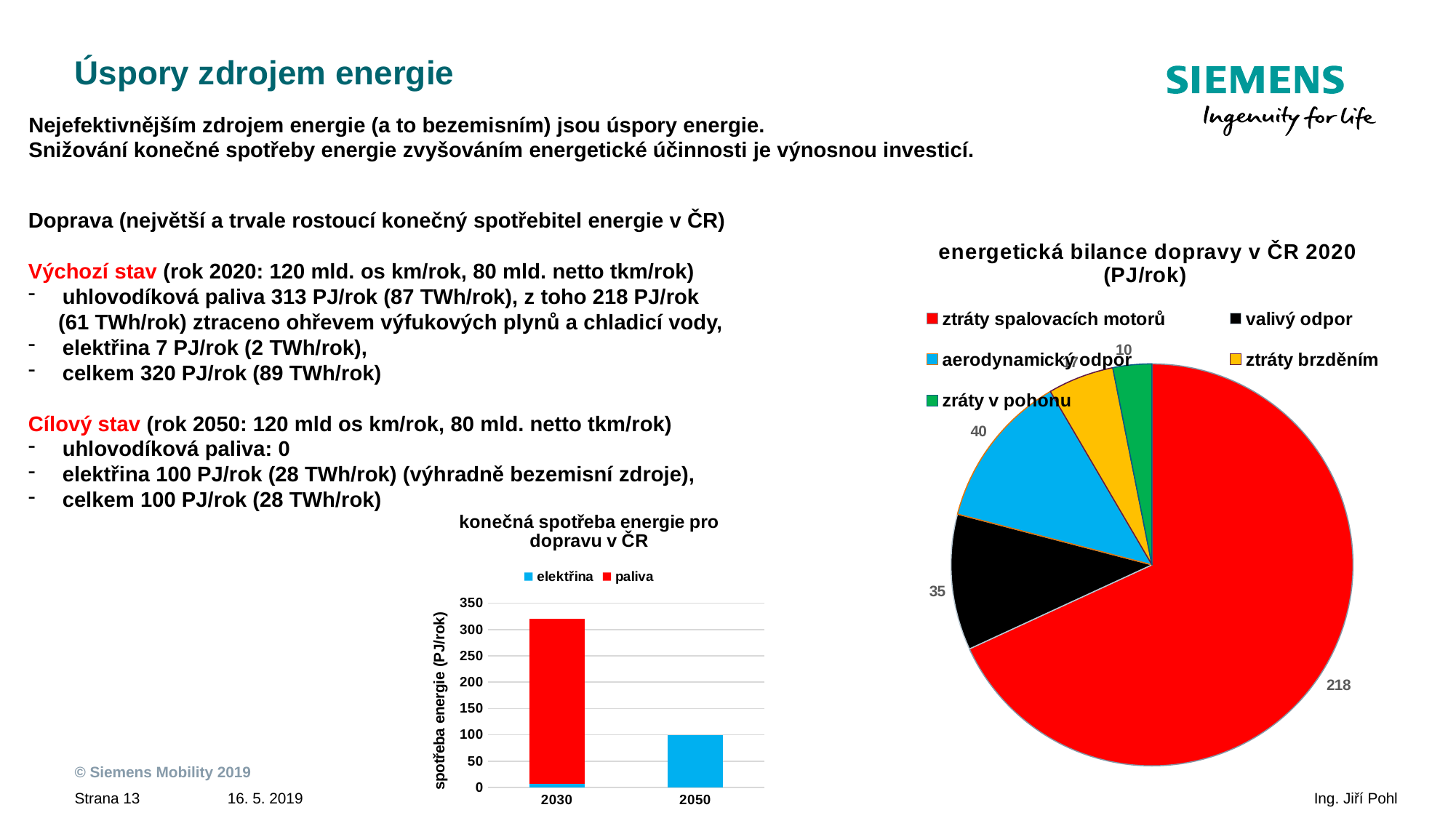
How many categories does the legend of the pie chart 'energetická bilance dopravy v ČR 2020' list? 5 In the pie chart 'energetická bilance dopravy v ČR 2020', which category has the largest slice? ztráty spalovacích motorů In the pie chart 'energetická bilance dopravy v ČR 2020', what is the value for ztráty spalovacích motorů? 218 In the pie chart 'energetická bilance dopravy v ČR 2020', what is the value for aerodynamický odpor? 40 What kind of chart is the chart titled 'konečná spotřeba energie pro dopravu v ČR'? bar chart What kind of chart is the chart titled 'energetická bilance dopravy v ČR 2020 (PJ/rok)'? pie chart In the bar chart 'konečná spotřeba energie pro dopravu v ČR', is the value for paliva in 2030 greater or less than 300? greater In the pie chart 'energetická bilance dopravy v ČR 2020', what is the value for zráty v pohonu? 10 In the pie chart 'energetická bilance dopravy v ČR 2020', what is the value for valivý odpor? 35 How many years are shown on the x axis of the bar chart 'konečná spotřeba energie pro dopravu v ČR'? 2 In the bar chart 'konečná spotřeba energie pro dopravu v ČR', which year has the higher total energy consumption, 2030 or 2050? 2030 In the pie chart 'energetická bilance dopravy v ČR 2020', what is the difference between aerodynamický odpor and valivý odpor? 5